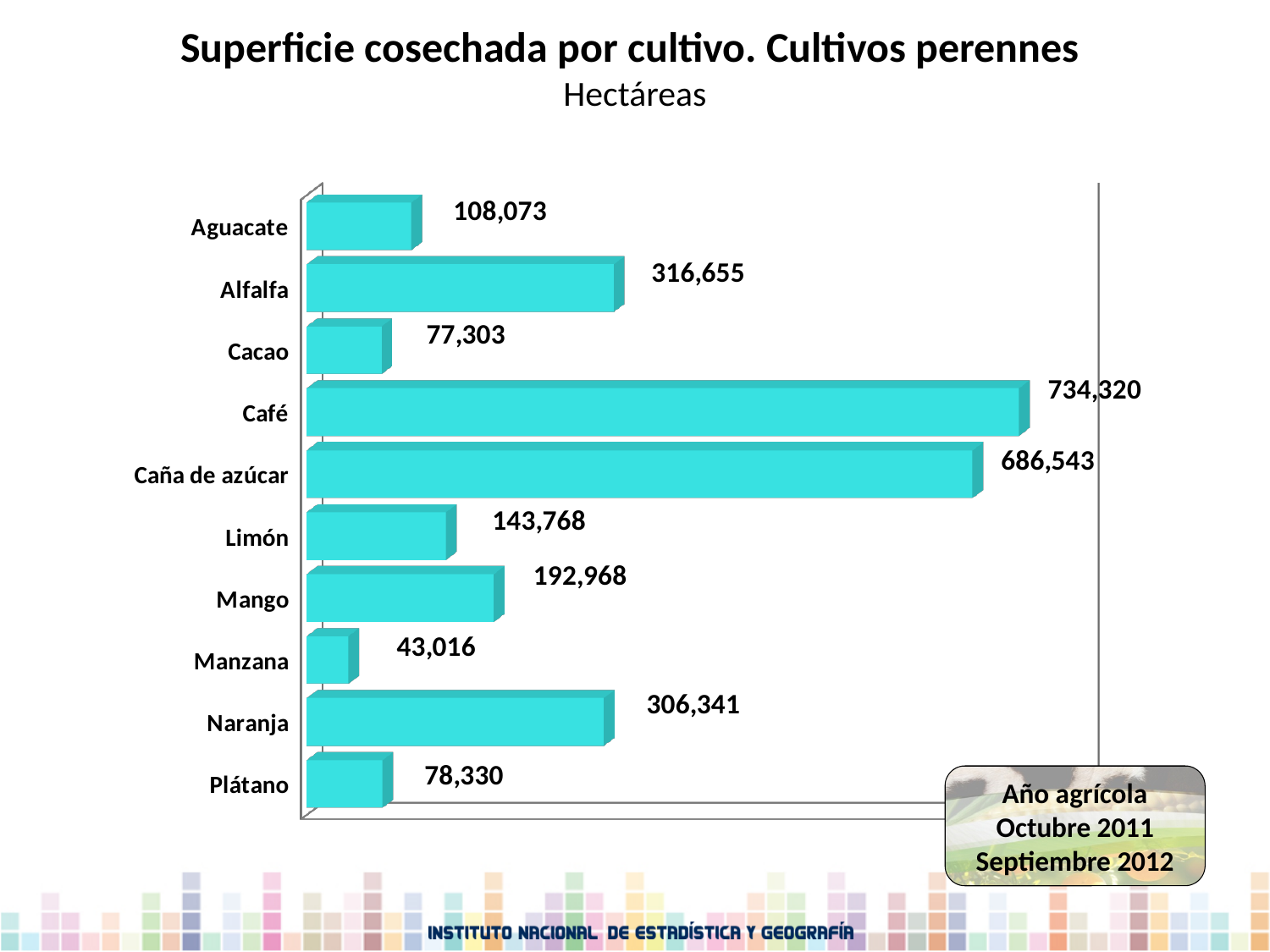
Which has a larger harvested area, Cacao or Plátano? Plátano Which crop has the smallest harvested area? Manzana What is the harvested area for Naranja? 306,341 Which has a larger harvested area, Mango or Limón? Mango What unit is given in the chart subtitle? Hectáreas What is the harvested area for Café? 734,320 What is the difference between the harvested area of Alfalfa and Naranja? 10,314 Which crop has the largest harvested area? Café What is the difference between the harvested area of Café and Caña de azúcar? 47,777 What is the harvested area for Manzana? 43,016 What kind of chart is shown on the slide? Bar chart How many crops are shown in the chart? 10